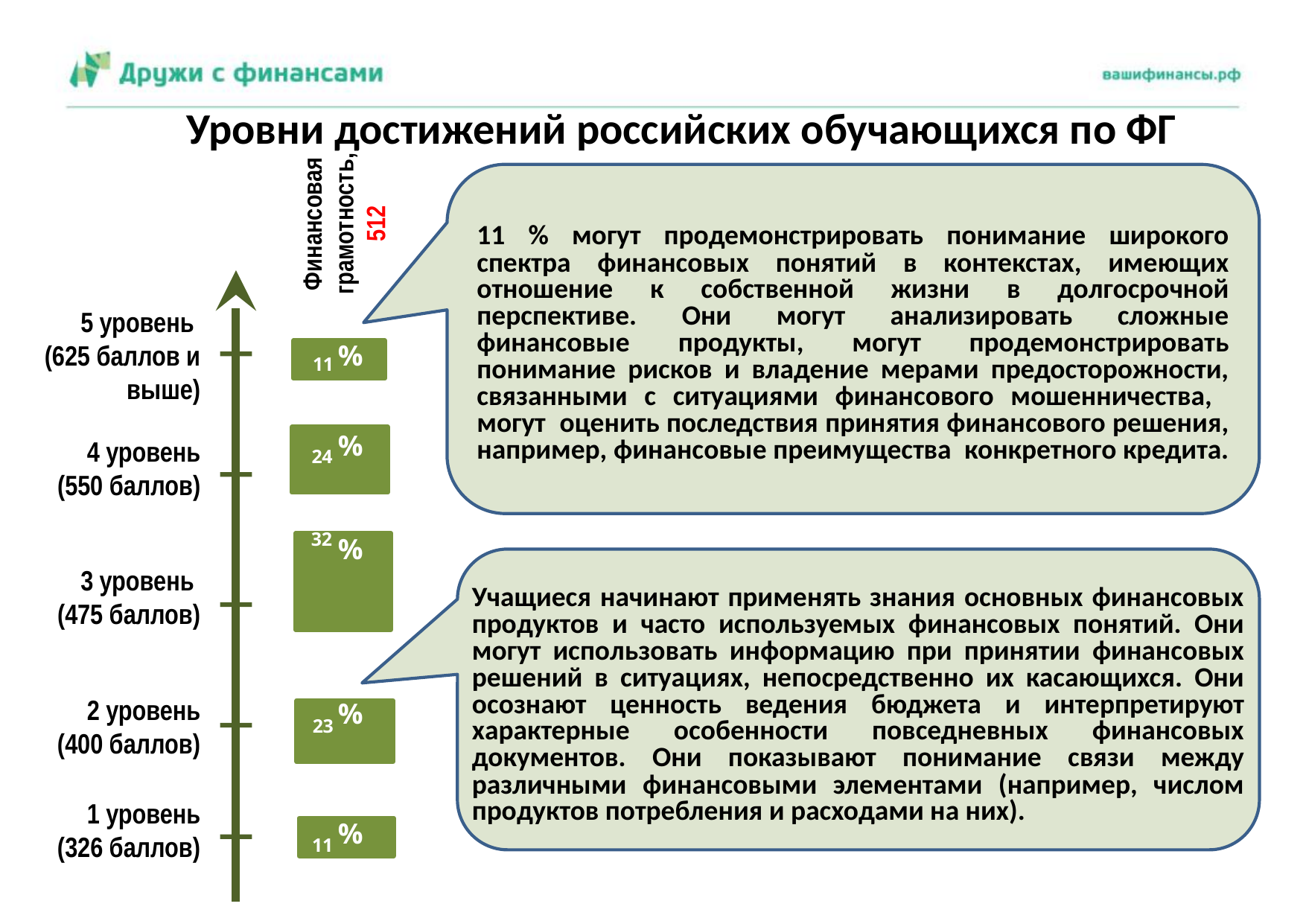
How many achievement levels are shown on the slide? 5 What score is shown in red next to the column heading 'Финансовая грамотность'? 512 What percentage of Russian students reached level 3 (475 баллов) in financial literacy? 32 % Which level has the largest share of students? 3 уровень (475 баллов) Do the shares of students at level 1 and level 5 have the same value? Yes, both 11 % What percentage of students are at level 2 (400 баллов)? 23 % What is the title of the slide? Уровни достижений российских обучающихся по ФГ What is the combined share of students at level 1 and level 5? 22 % What percentage of students reached level 5 (625 баллов и выше)? 11 % Which has a larger share of students: level 4 or level 2? 4 уровень What percentage of students are at level 4 (550 баллов)? 24 % What is the difference in percentage points between level 3 and level 4? 8